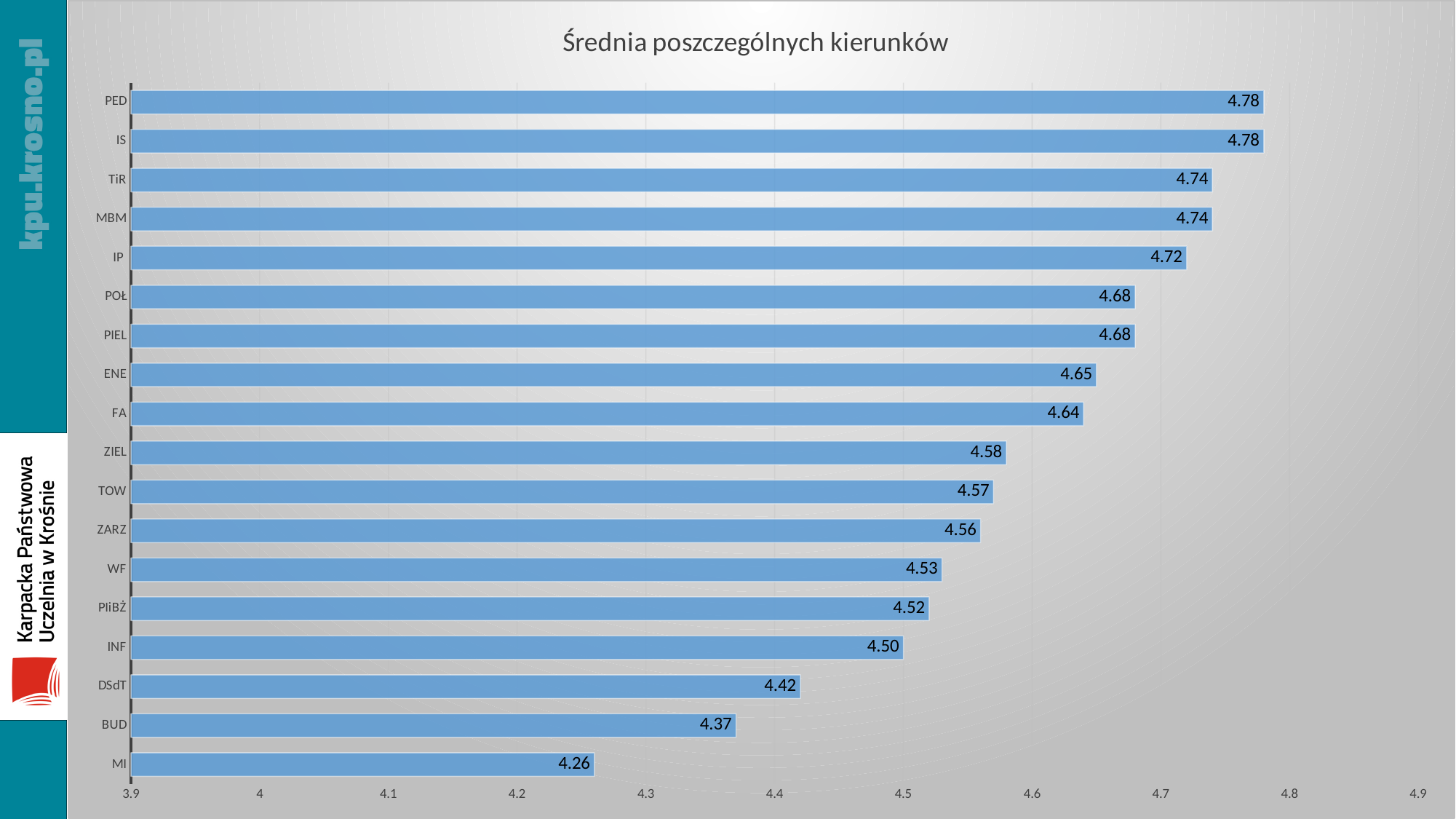
What is the value for ZIEL? 4.58 Which category has the lowest value? MI What is the value for INF? 4.50 Is the value for TOW greater or less than 4.5? greater What kind of chart is shown on the slide? bar chart How many categories are shown in the chart? 18 What is the value for BUD? 4.37 What is the title of the chart? Średnia poszczególnych kierunków What is the value for IP? 4.72 Which is larger, the value for ENE or the value for WF? ENE What is the difference between the values for TiR and DSdT? 0.32 What is the difference between the values for PED and MI? 0.52